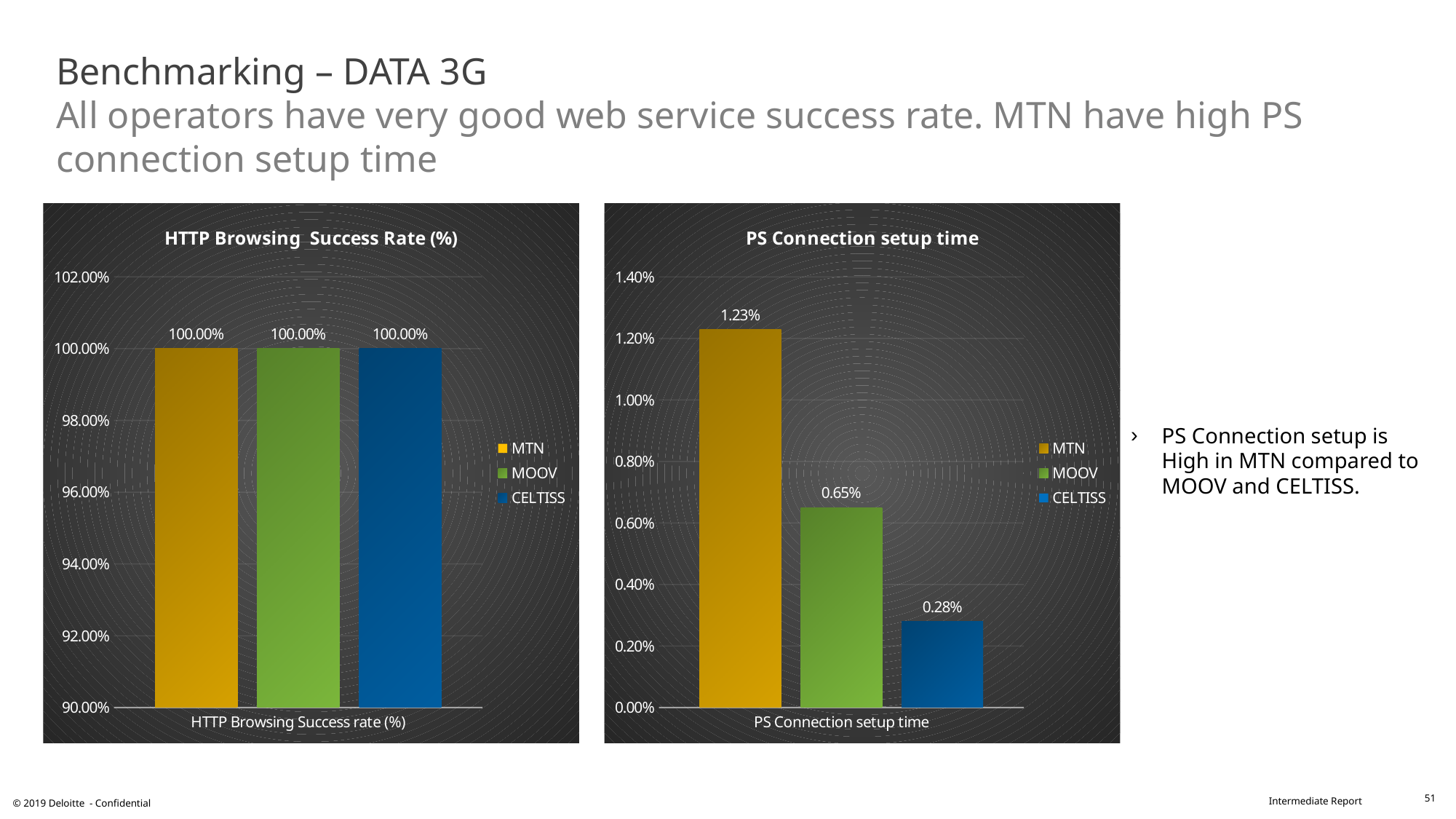
What kind of chart is the PS Connection setup time chart? bar chart In the PS Connection setup time chart, which colour represents CELTISS? blue In the PS Connection setup time chart, is the value for MTN greater or less than 1.00%? greater In the PS Connection setup time chart, what is the value for MTN? 1.23% In the PS Connection setup time chart, what is the difference between the MTN and MOOV values? 0.58% In the PS Connection setup time chart, what is the value for CELTISS? 0.28% In the PS Connection setup time chart, which operator has the lowest value? CELTISS In the PS Connection setup time chart, what is the value for MOOV? 0.65% In the PS Connection setup time chart, which operator has the highest value? MTN In the HTTP Browsing Success Rate (%) chart, what is the value for MOOV? 100.00% How many series does the legend of the HTTP Browsing Success Rate (%) chart list? 3 In the PS Connection setup time chart, which is larger, the value for MOOV or the value for CELTISS? MOOV